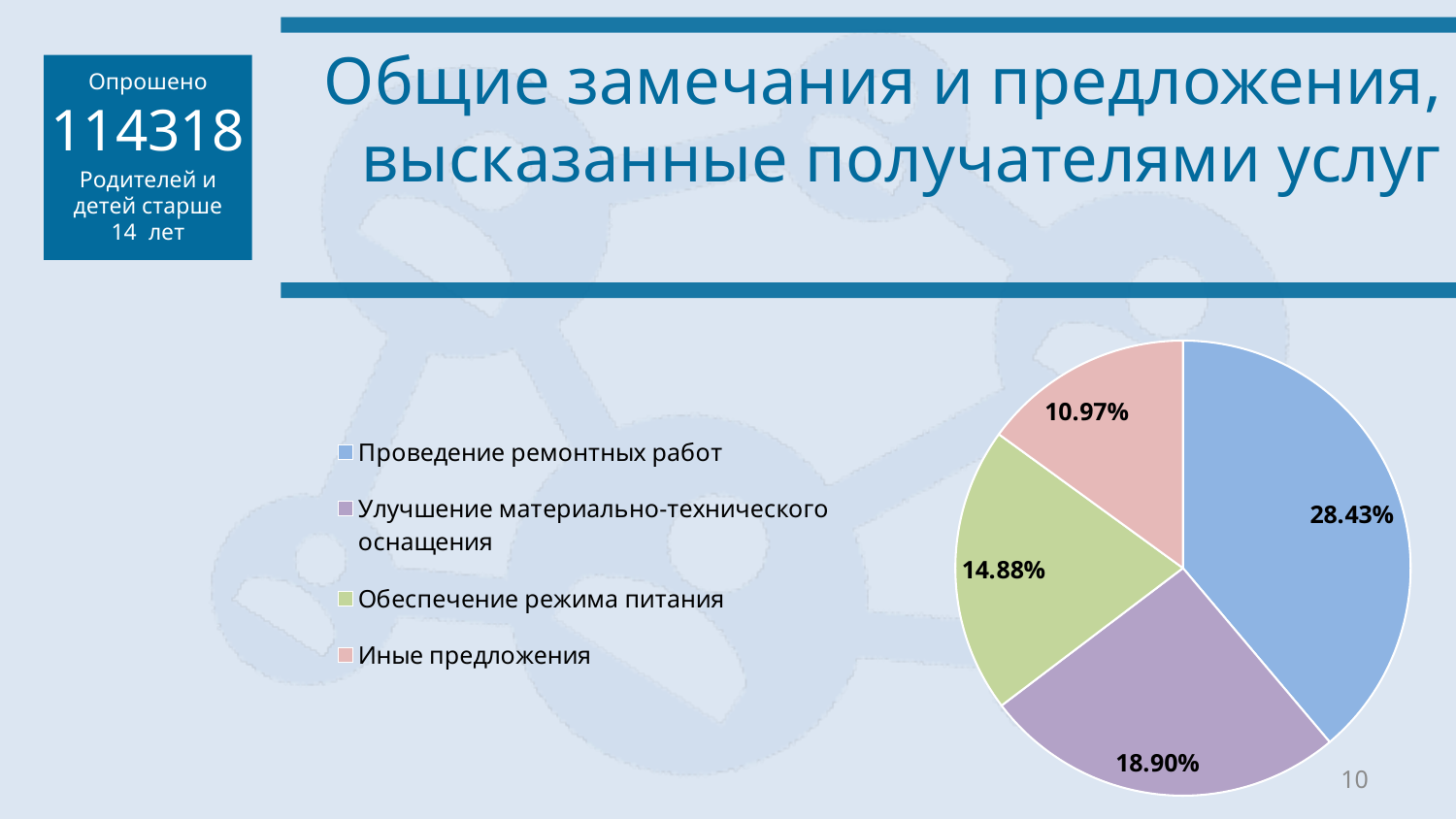
What kind of chart is shown on the slide? Pie chart Which category has the smallest slice of the pie chart? Иные предложения What is the difference between the values for "Проведение ремонтных работ" and "Улучшение материально-технического оснащения"? 9.53% What is the value shown for "Обеспечение режима питания"? 14.88% How many entries does the legend of the pie chart list? 4 What is the value shown for "Иные предложения"? 10.97% How many slices does the pie chart have? 4 Which is larger: the value for "Обеспечение режима питания" or the value for "Иные предложения"? Обеспечение режима питания What colour is the slice for "Обеспечение режима питания"? Green Which category has the largest slice of the pie chart? Проведение ремонтных работ What is the value shown for "Проведение ремонтных работ"? 28.43% What is the value shown for "Улучшение материально-технического оснащения"? 18.90%